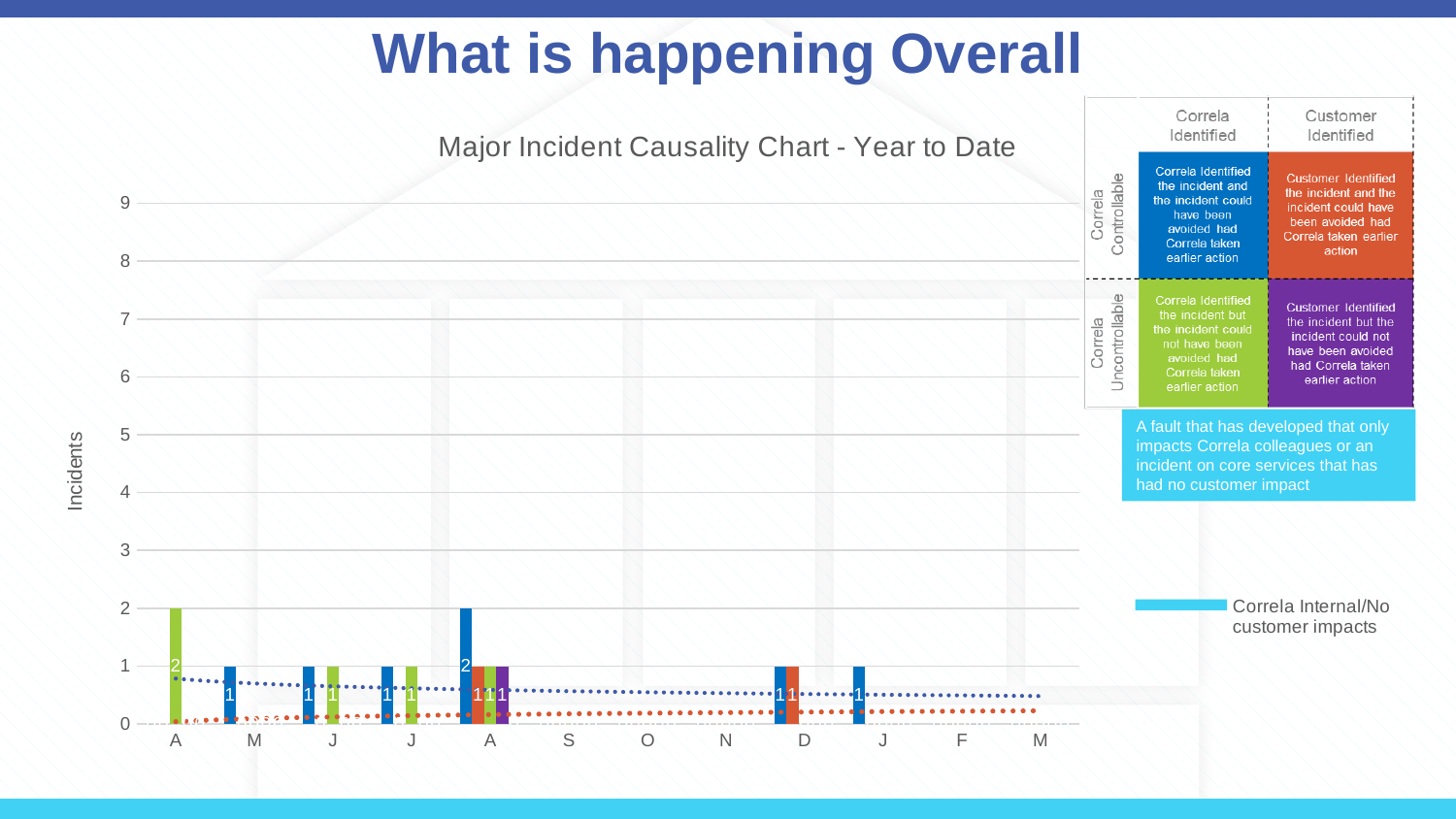
What is the difference between the blue bar and the orange bar for August (second A)? 1 How many month categories are shown along the x axis of the chart? 12 What is the value of the green bar for the first month (A) on the chart? 2 What kind of chart is the Major Incident Causality Chart - Year to Date? bar chart How many bars are plotted for the August (second A) category? 4 What is the value of the blue bar for the month labelled M (May)? 1 How many month categories on the x axis have no bars at all? 5 What does the light blue legend entry to the right of the chart represent? Correla Internal/No customer impacts What is the label on the y axis of the chart? Incidents Which is larger: the green bar for April (first A) or the blue bar for May (M)? the green bar for April What is the value of the blue bar for the month labelled A in the middle of the x axis (August)? 2 Is the green bar for April (first A) greater or less than 1? greater